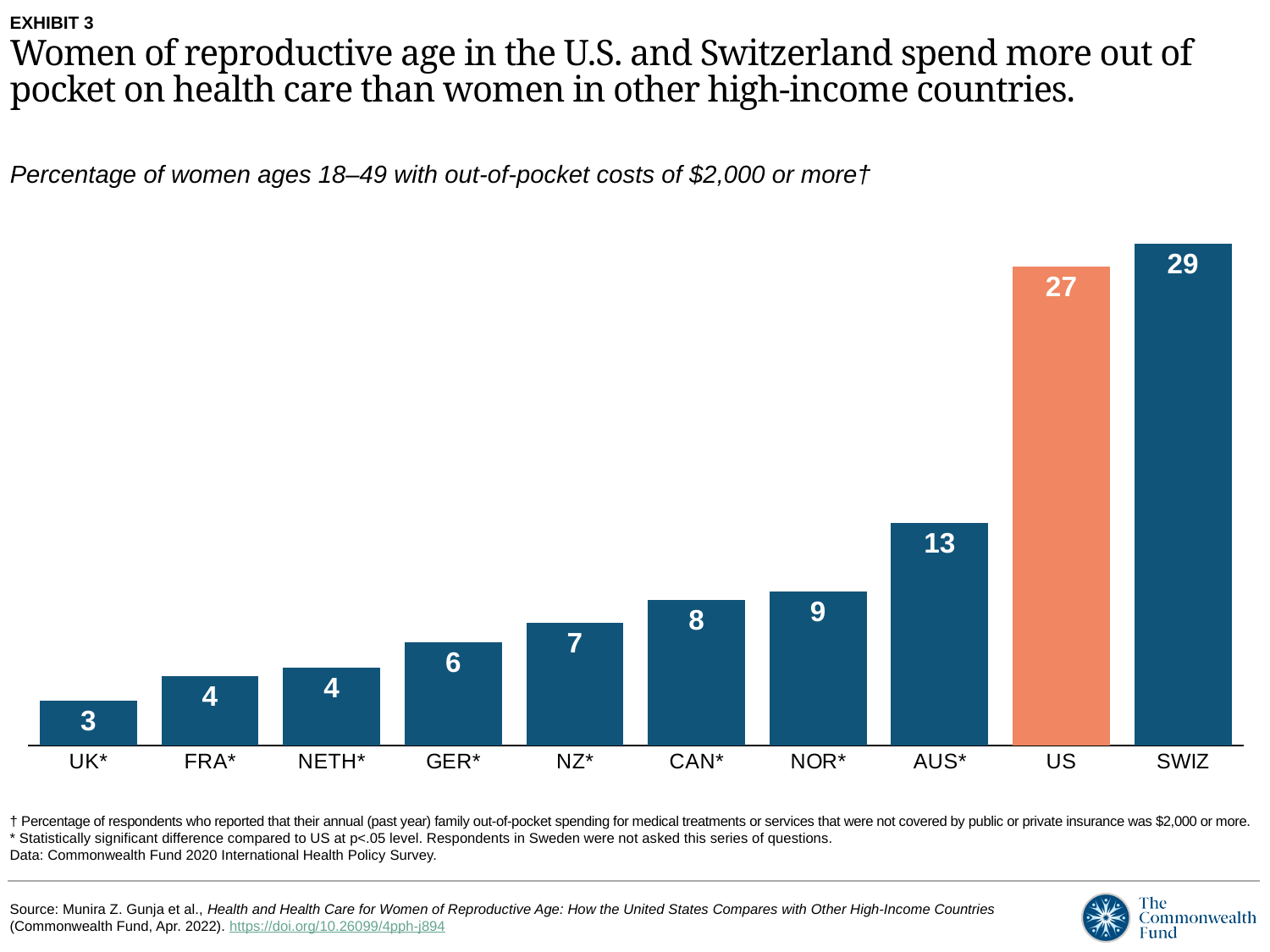
What is the value for the US? 27 Do the values rise or fall from left to right across the countries? Rise Which is larger, the value for NOR* or the value for CAN*? NOR* What is the value for GER*? 6 Which country has the lowest value? UK* What is the value for AUS*? 13 How many countries are shown on the chart? 10 What is the difference between the values for SWIZ and the US? 2 Which country has the highest value? SWIZ What kind of chart is shown on the slide? Bar chart Which country's bar is shown in a different colour (orange) from the others? US What is the difference between the values for the US and AUS*? 14